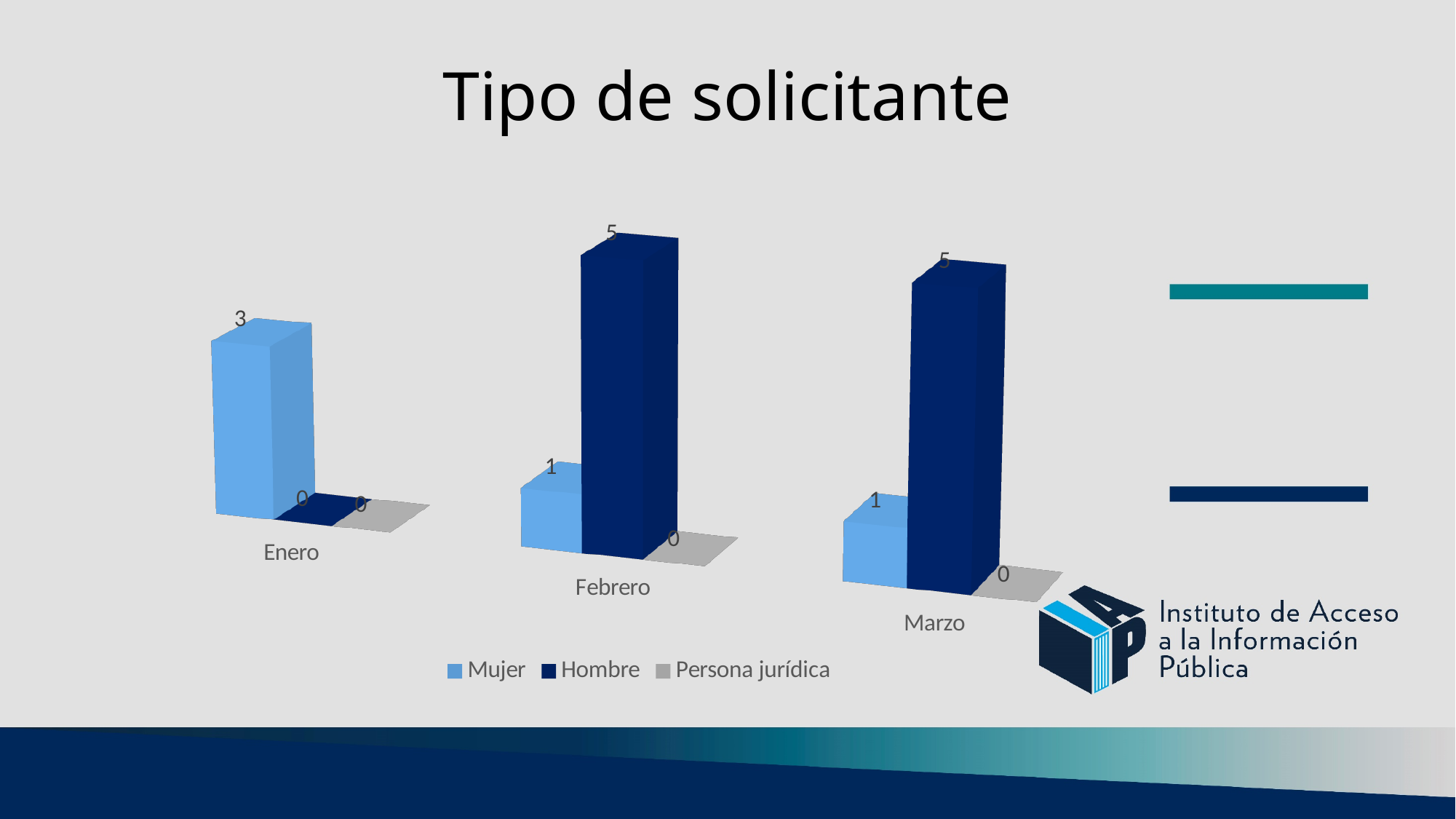
In which month is the Mujer value highest? Enero What is the value for Mujer in Enero? 3 What is the value for Hombre in Febrero? 5 What is the value for Persona jurídica in Marzo? 0 What is the value for Mujer in Marzo? 1 What is the title of the chart? Tipo de solicitante How many months are shown on the x axis? 3 How many series does the legend list? 3 What is the difference between the Hombre and Mujer values in Febrero? 4 In which month is the Hombre value lowest? Enero Which is larger in Marzo, the Mujer value or the Hombre value? Hombre What kind of chart is shown on the slide? Bar chart